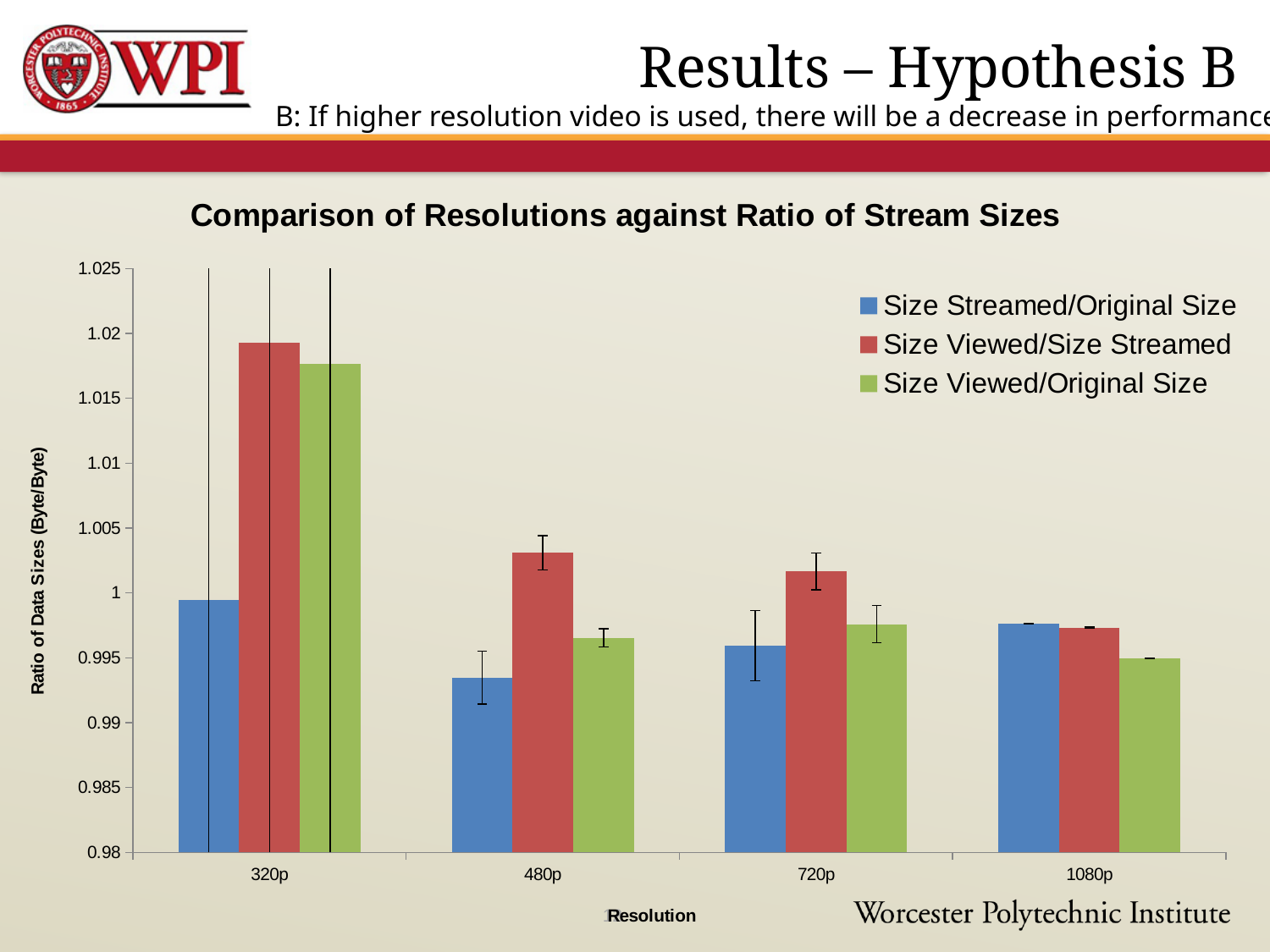
Does the Size Viewed/Size Streamed value rise or fall as resolution increases from 320p to 1080p? fall Is the Size Viewed/Size Streamed value for 720p greater or less than 1? greater What kind of chart is shown on the slide? bar chart What is the title of the chart? Comparison of Resolutions against Ratio of Stream Sizes How many series does the legend list? 3 Which resolution has the lowest Size Streamed/Original Size value? 480p Which resolution has the highest Size Viewed/Size Streamed value? 320p At 1080p, which is larger: Size Streamed/Original Size or Size Viewed/Original Size? Size Streamed/Original Size How many resolution categories are shown on the x axis? 4 Is the Size Streamed/Original Size value for 480p greater or less than 0.995? less At 480p, which is larger: Size Viewed/Size Streamed or Size Streamed/Original Size? Size Viewed/Size Streamed Is the Size Viewed/Size Streamed value for 320p greater or less than 1.015? greater